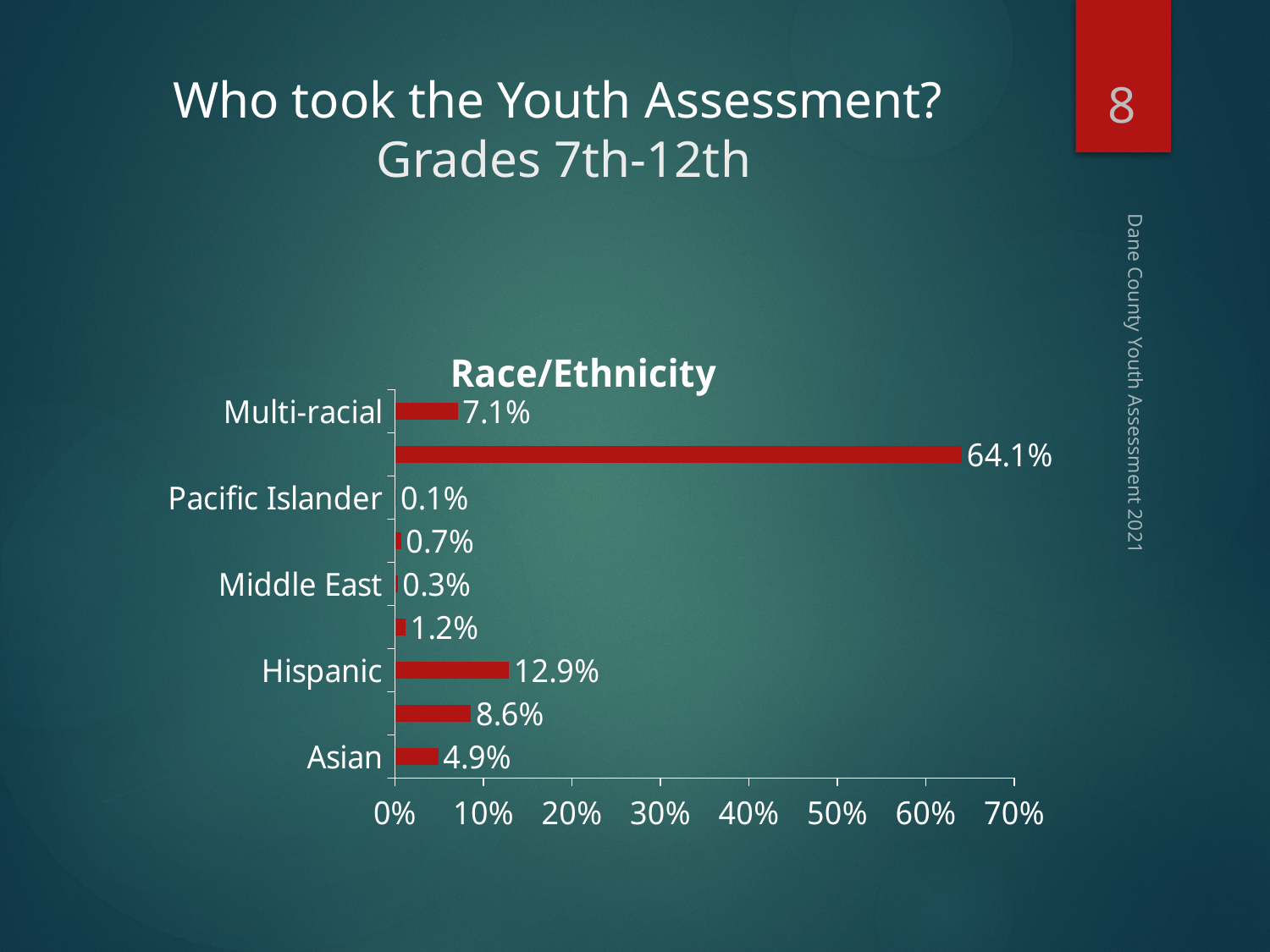
What is the value for Hispanic in the Race/Ethnicity chart? 12.9% Is the value for Hispanic greater or less than 10%? greater What is the difference between the Hispanic and Asian values in the Race/Ethnicity chart? 8.0% What is the largest value shown in the Race/Ethnicity chart? 64.1% What is the value for Multi-racial in the Race/Ethnicity chart? 7.1% How many bars are plotted in the Race/Ethnicity chart? 9 What is the value for Pacific Islander in the Race/Ethnicity chart? 0.1% Which labeled category has the lowest value in the Race/Ethnicity chart? Pacific Islander Which is larger in the Race/Ethnicity chart, Multi-racial or Asian? Multi-racial What is the value for Middle East in the Race/Ethnicity chart? 0.3% What is the value for Asian in the Race/Ethnicity chart? 4.9% What kind of chart is shown on the slide? Bar chart